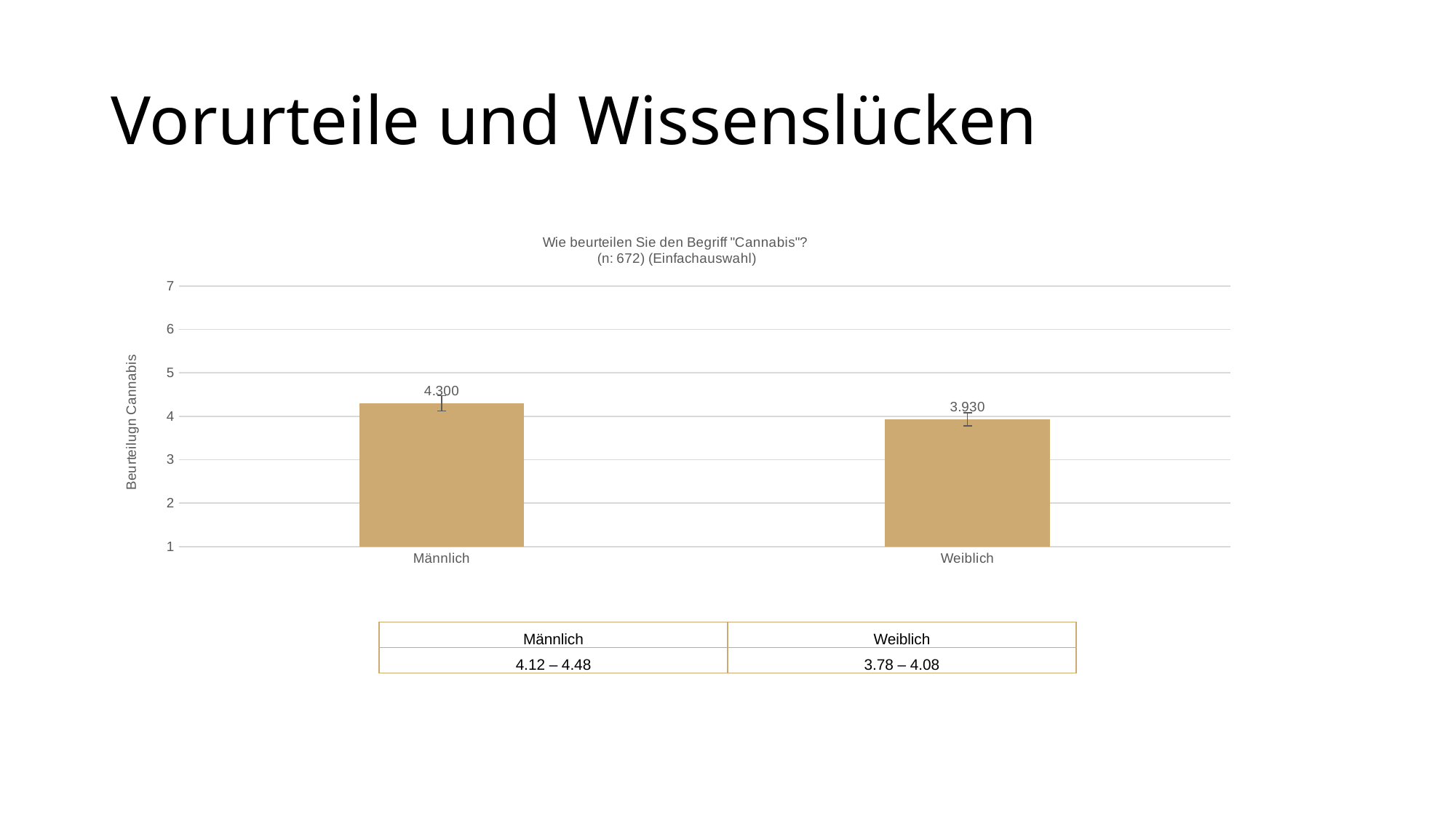
Which is larger, the value for Männlich or the value for Weiblich? Männlich What kind of chart is shown on the slide? bar chart What is the value for Männlich? 4.300 What is the title of the chart? Wie beurteilen Sie den Begriff "Cannabis"? (n: 672) (Einfachauswahl) How many categories are shown on the x axis? 2 Is the value for Weiblich greater or less than 4? less Which category has the lowest value? Weiblich What is the value for Weiblich? 3.930 Is the value for Männlich greater or less than 4? greater What is the label of the y axis? Beurteilugn Cannabis Which category has the highest value? Männlich What is the difference between the values for Männlich and Weiblich? 0.370